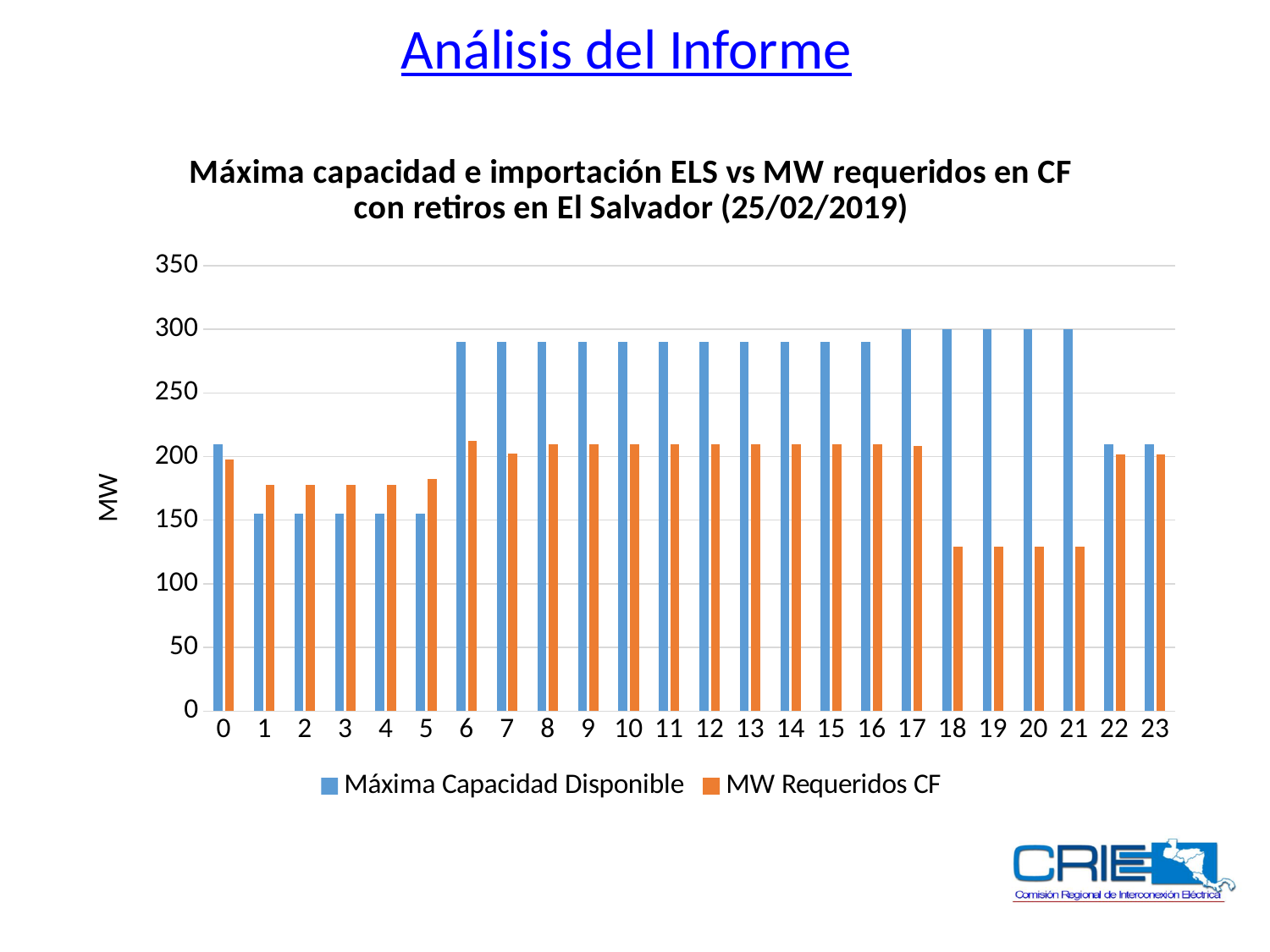
How many series does the legend list? 2 Is the value of MW Requeridos CF at hour 6 greater or less than 200? greater What are the two series named in the legend? Máxima Capacidad Disponible and MW Requeridos CF What kind of chart is shown on the slide? bar chart At hour 20, which series has the larger value, Máxima Capacidad Disponible or MW Requeridos CF? Máxima Capacidad Disponible Is the value of Máxima Capacidad Disponible at hour 3 greater or less than 200? less Do the MW Requeridos CF values rise or fall from hour 17 to hour 18? fall What is the label on the vertical axis? MW At hour 2, which series has the larger value, Máxima Capacidad Disponible or MW Requeridos CF? MW Requeridos CF Is the value of MW Requeridos CF at hour 19 greater or less than 150? less How many hour categories are shown on the x axis? 24